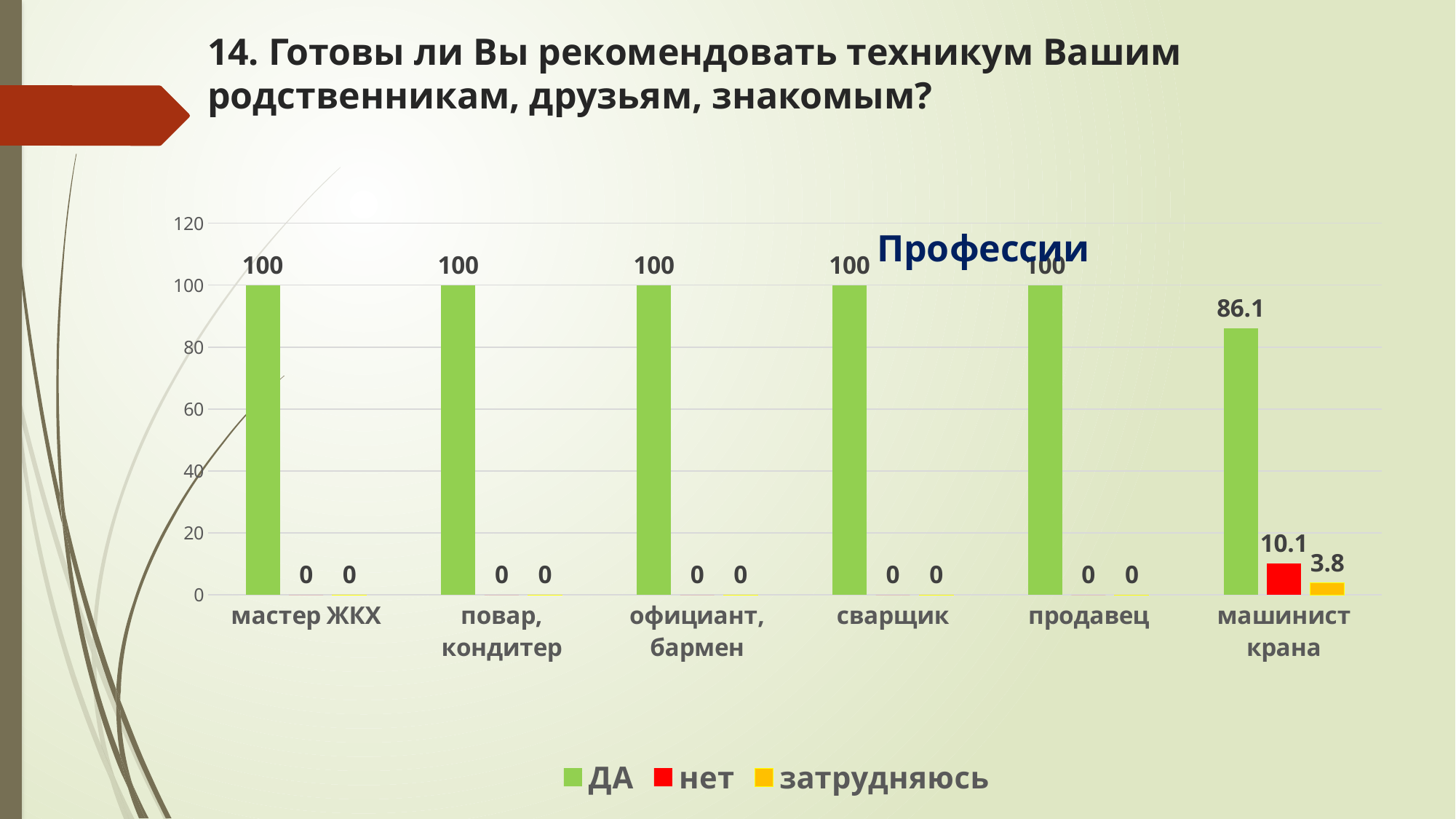
What is the value of the ДА series for машинист крана? 86.1 What kind of chart is shown on the slide? bar chart How many categories are shown on the x axis? 6 What is the value of the затрудняюсь series for машинист крана? 3.8 What is the difference between the ДА value for повар, кондитер and the ДА value for машинист крана? 13.9 What is the value of the ДА series for сварщик? 100 What is the value of the нет series for машинист крана? 10.1 Which category has the highest value for the нет series? машинист крана Which category has the lowest value for the ДА series? машинист крана How many series does the legend list? 3 For машинист крана, which is larger: the нет value or the затрудняюсь value? нет What is the value of the нет series for продавец? 0